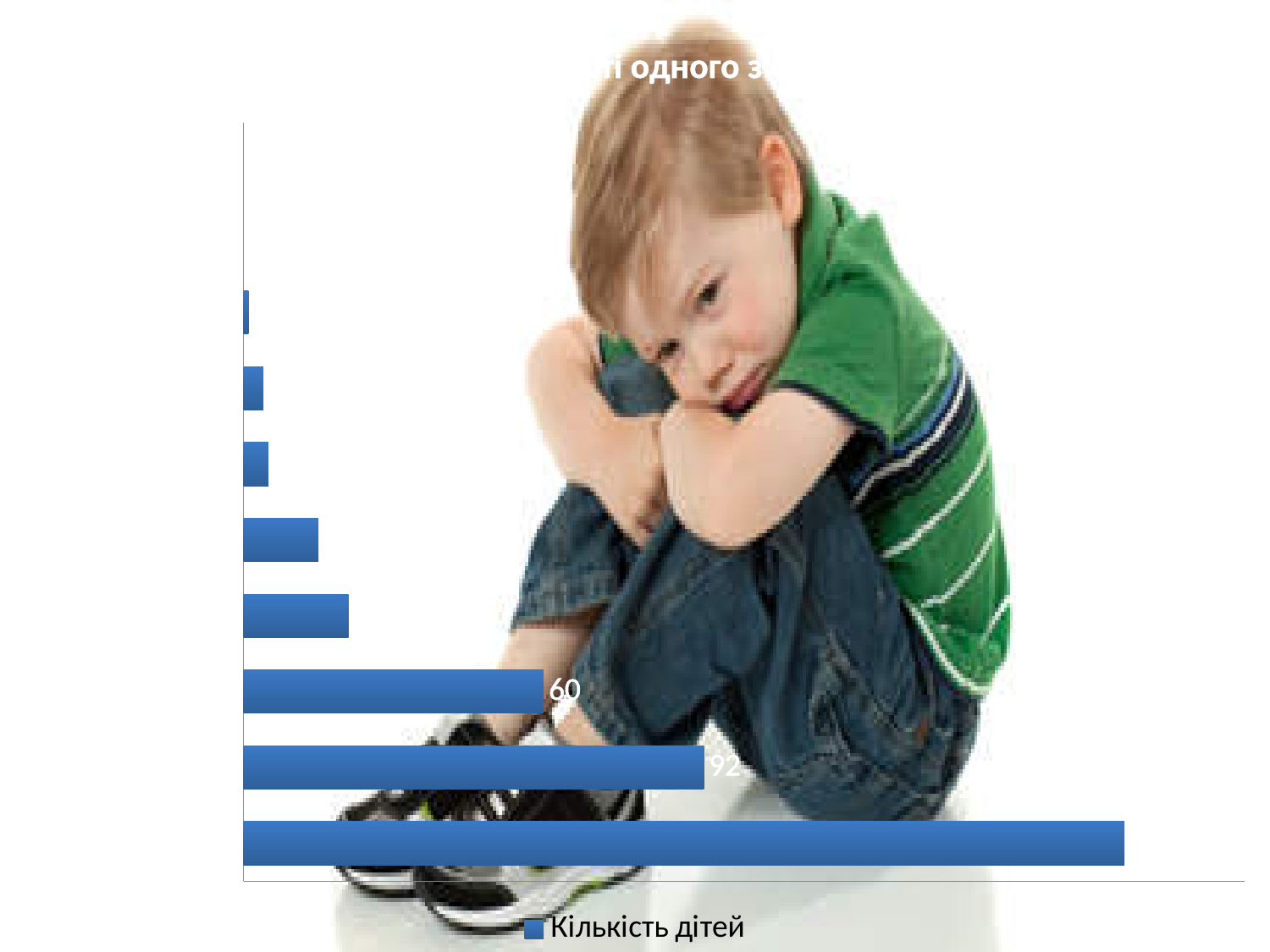
Which bar is the shortest in the chart? the top bar What colour are the bars in the chart? blue What is the name of the series shown in the legend? Кількість дітей Which is larger, the bar labelled 60 or the bar labelled 92? 92 What kind of chart is shown on the slide? bar chart How many series does the legend list? 1 How many bars are plotted in the chart? 8 What value is printed on the second bar from the bottom? 92 What is the difference between the bar labelled 92 and the bar labelled 60? 32 What value is printed on the third bar from the bottom? 60 Which bar is the longest in the chart? the bottom bar Do the bar lengths increase or decrease going from the top bar to the bottom bar? increase